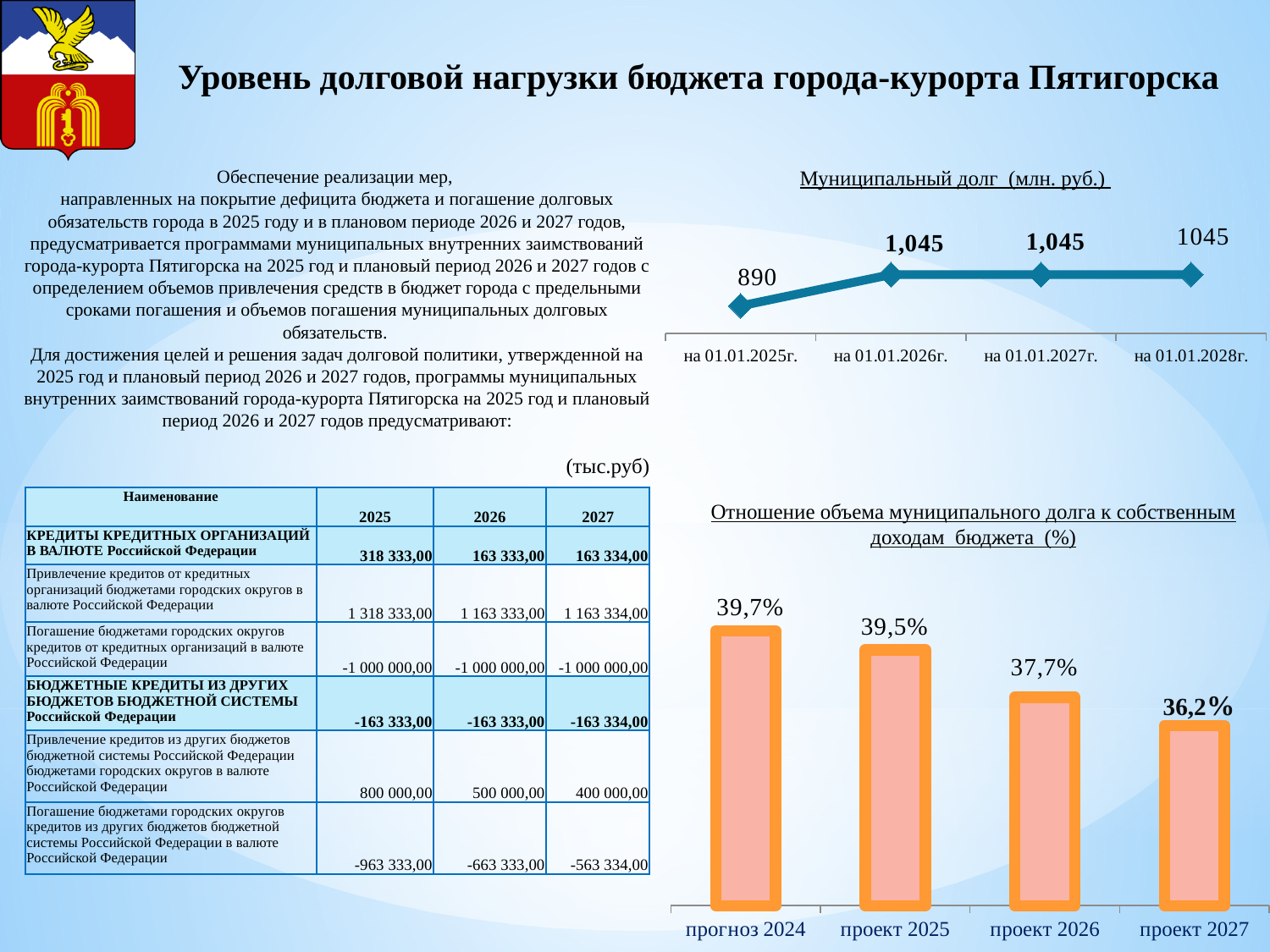
In the chart 'Отношение объема муниципального долга к собственным доходам бюджета (%)', which category has the lowest value? проект 2027 In the chart 'Муниципальный долг (млн. руб.)', do the values rise or fall from 'на 01.01.2025г.' to 'на 01.01.2026г.'? rise What kind of chart is 'Отношение объема муниципального долга к собственным доходам бюджета (%)'? bar chart In the chart 'Отношение объема муниципального долга к собственным доходам бюджета (%)', how many bars are there? 4 In the chart 'Отношение объема муниципального долга к собственным доходам бюджета (%)', what is the value for 'прогноз 2024'? 39,7% In the chart 'Муниципальный долг (млн. руб.)', what is the value for 'на 01.01.2026г.'? 1,045 In the chart 'Отношение объема муниципального долга к собственным доходам бюджета (%)', do the values rise or fall along the x axis? fall In the chart 'Отношение объема муниципального долга к собственным доходам бюджета (%)', what is the value for 'проект 2026'? 37,7% In the chart 'Муниципальный долг (млн. руб.)', which date has the lowest value? на 01.01.2025г. In the chart 'Муниципальный долг (млн. руб.)', how many data points are plotted? 4 What kind of chart is 'Муниципальный долг (млн. руб.)'? line chart In the chart 'Муниципальный долг (млн. руб.)', what is the value for 'на 01.01.2025г.'? 890